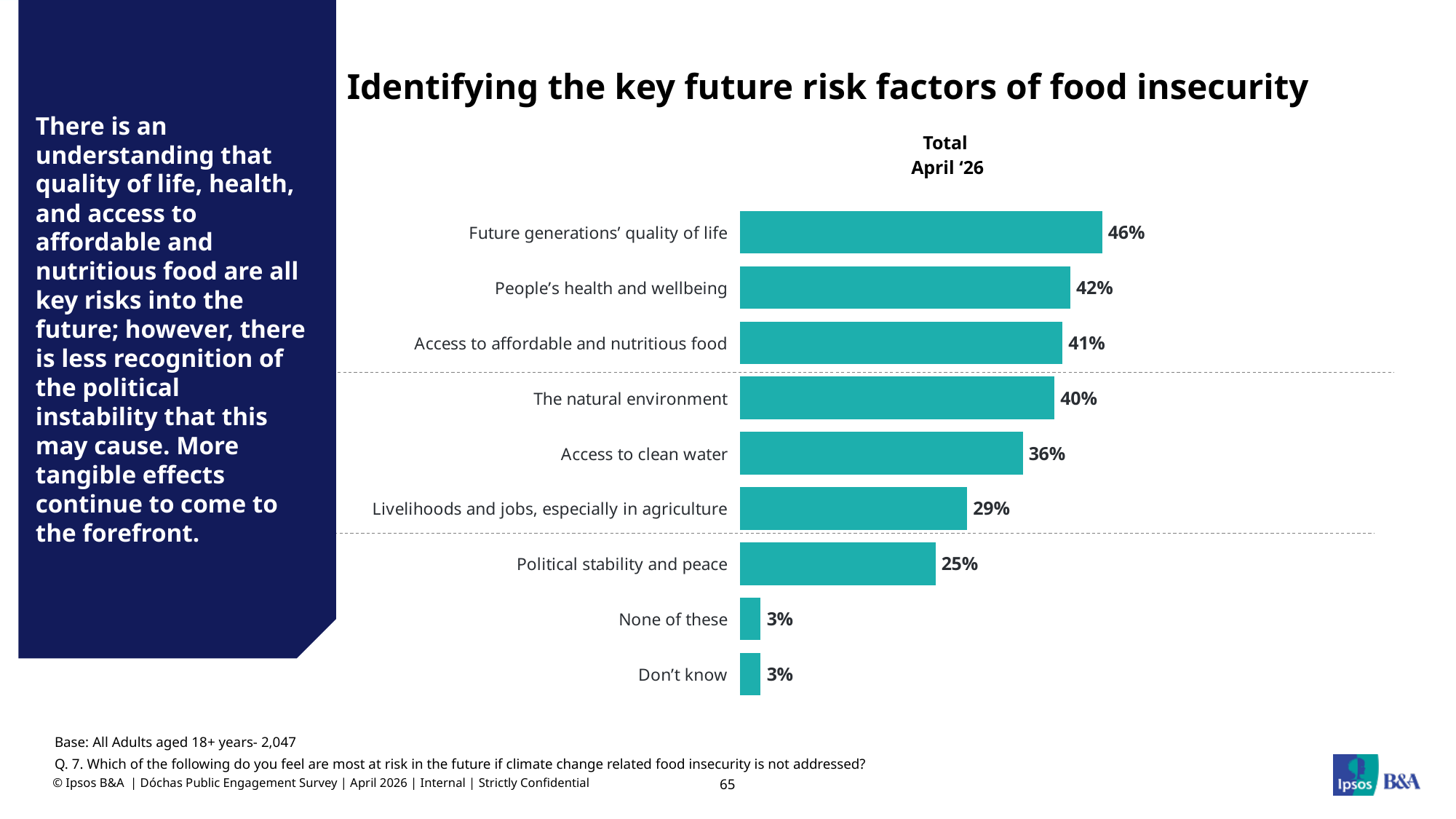
What is the difference between 'Future generations' quality of life' and 'Political stability and peace'? 21% What percentage is shown for 'Political stability and peace'? 25% What is the title of the chart? Identifying the key future risk factors of food insecurity Which category has the highest value? Future generations' quality of life What value is shown for 'Don't know'? 3% What is the difference between 'People's health and wellbeing' and 'Livelihoods and jobs, especially in agriculture'? 13% Which is larger: 'The natural environment' or 'Access to clean water'? The natural environment What column heading appears above the bars? Total April '26 What kind of chart is shown on the slide? Bar chart What is the value for 'Access to clean water'? 36% What percentage is shown for 'Future generations' quality of life'? 46% How many categories are shown in the chart? 9